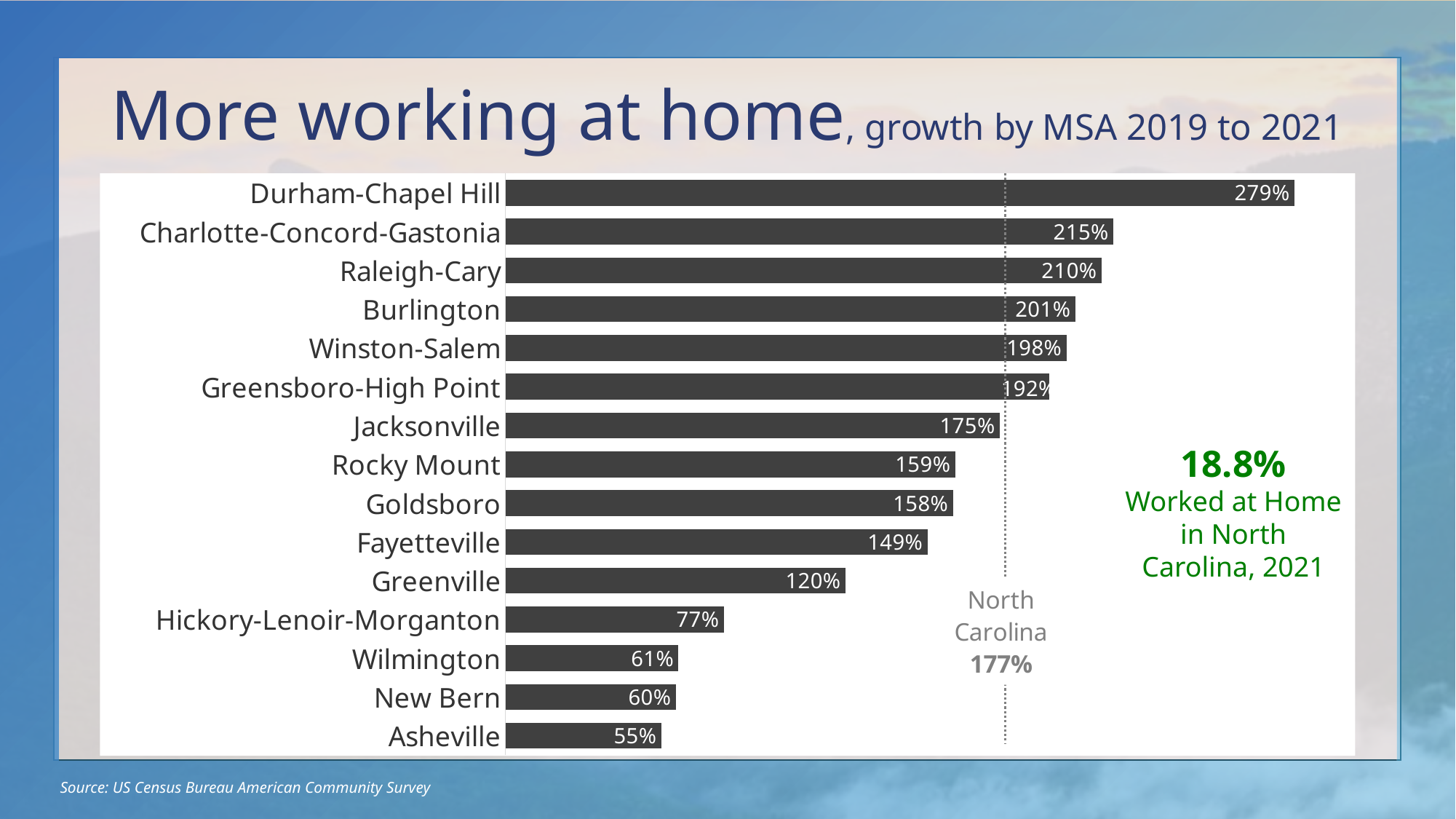
What is the difference between the values for Charlotte-Concord-Gastonia and Raleigh-Cary? 5% How many MSAs are shown in the chart? 15 Which is larger, the value for Jacksonville or the value for Greenville? Jacksonville Which MSA has the lowest growth in working at home? Asheville Which MSA has the highest growth in working at home? Durham-Chapel Hill What is the value shown for Hickory-Lenoir-Morganton? 77% What is the value shown for Fayetteville? 149% What kind of chart is shown on the slide? Bar chart What is the growth in working at home for Durham-Chapel Hill? 279% What percentage worked at home in North Carolina in 2021, according to the green text? 18.8% What is the North Carolina value marked by the dotted reference line? 177% What is the difference between the values for Durham-Chapel Hill and Asheville? 224%